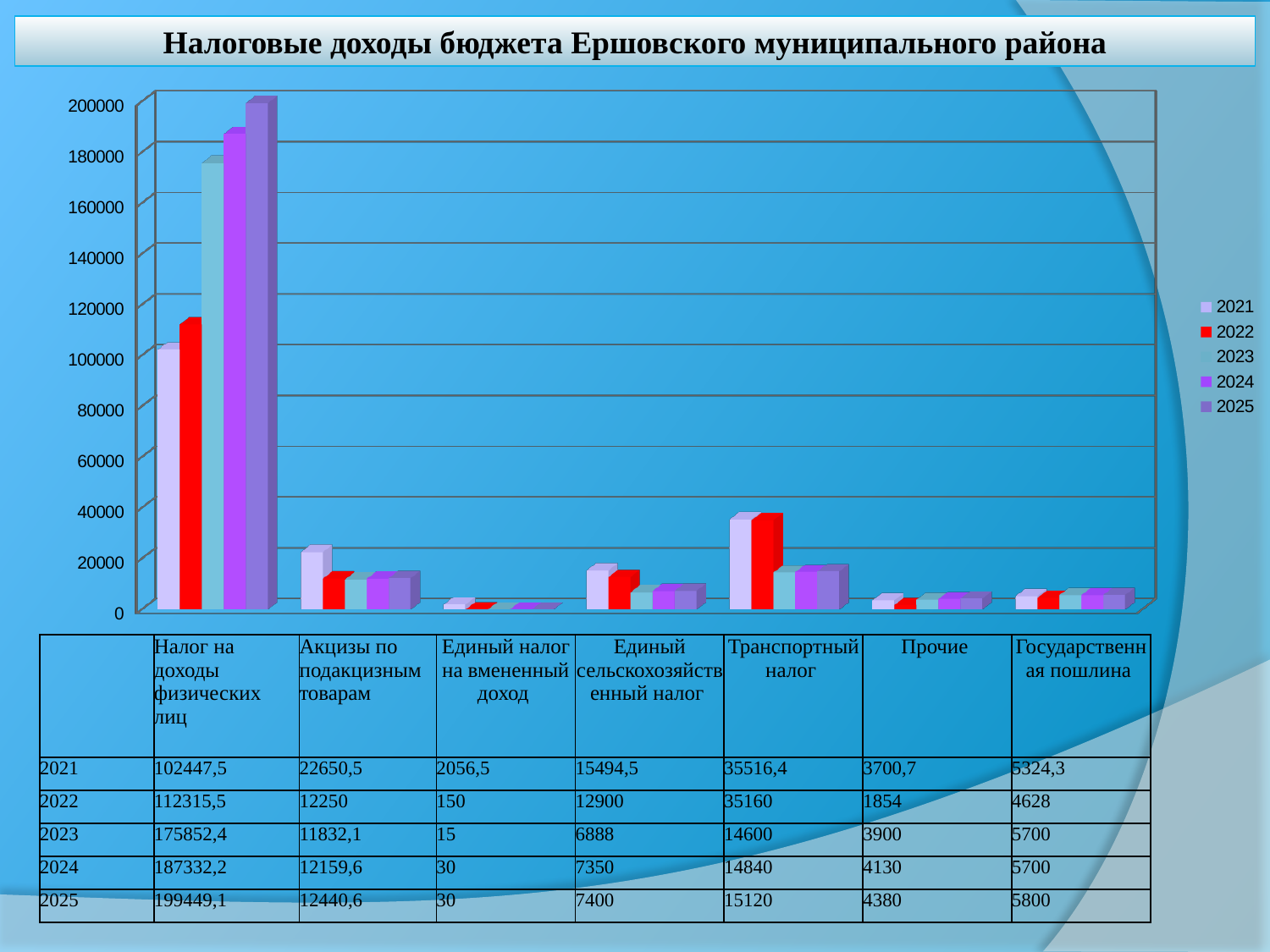
What is the value for Единый налог на вмененный доход in 2023? 15 Which is larger for Акцизы по подакцизным товарам: the 2021 value or the 2022 value? 2021 Do the values for Налог на доходы физических лиц rise or fall from 2021 to 2025? Rise What type of chart is shown on the slide? Bar chart Which category has the lowest value in 2022? Единый налог на вмененный доход How many series does the legend list? 5 Which category has the highest value in 2024? Налог на доходы физических лиц What is the value for Налог на доходы физических лиц in 2025? 199449,1 What is the difference between the 2025 and 2021 values for Налог на доходы физических лиц? 97001,6 What is the value for Транспортный налог in 2021? 35516,4 How many tax categories are plotted along the x axis? 7 Is the 2023 value for Налог на доходы физических лиц greater or less than 160000? greater